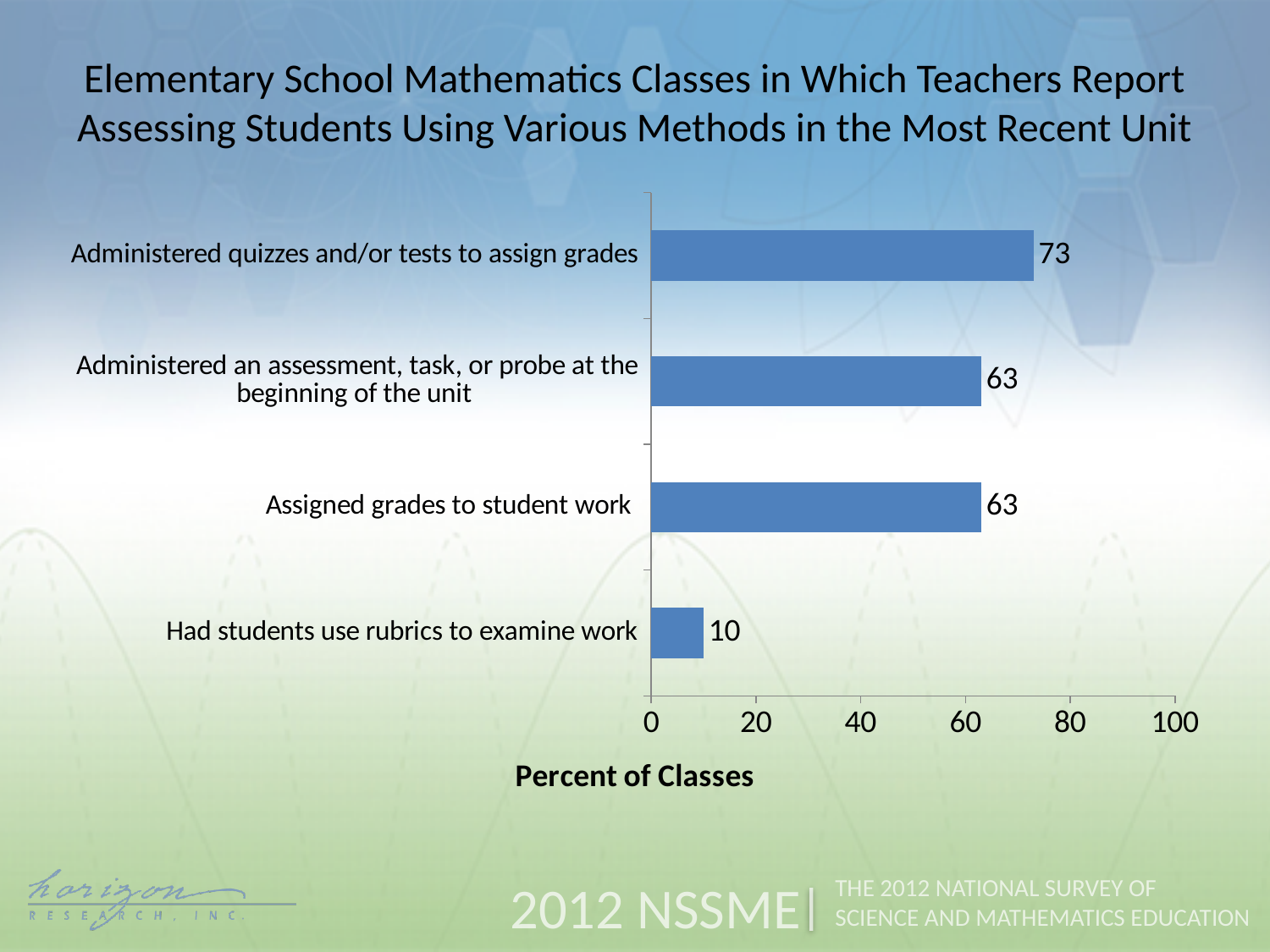
Is the value for 'Had students use rubrics to examine work' greater or less than 20? less What is the value for 'Administered an assessment, task, or probe at the beginning of the unit'? 63 Which is larger: the value for 'Administered quizzes and/or tests to assign grades' or the value for 'Assigned grades to student work'? Administered quizzes and/or tests to assign grades How many assessment methods are shown in the chart? 4 What is the difference between the value for 'Administered quizzes and/or tests to assign grades' and the value for 'Had students use rubrics to examine work'? 63 What is the value for 'Had students use rubrics to examine work'? 10 Which assessment method has the highest percent of classes? Administered quizzes and/or tests to assign grades What is the difference between the value for 'Administered quizzes and/or tests to assign grades' and the value for 'Assigned grades to student work'? 10 What percent of classes assigned grades to student work? 63 Which assessment method has the lowest percent of classes? Had students use rubrics to examine work What percent of classes administered quizzes and/or tests to assign grades? 73 What kind of chart is shown on the slide? bar chart